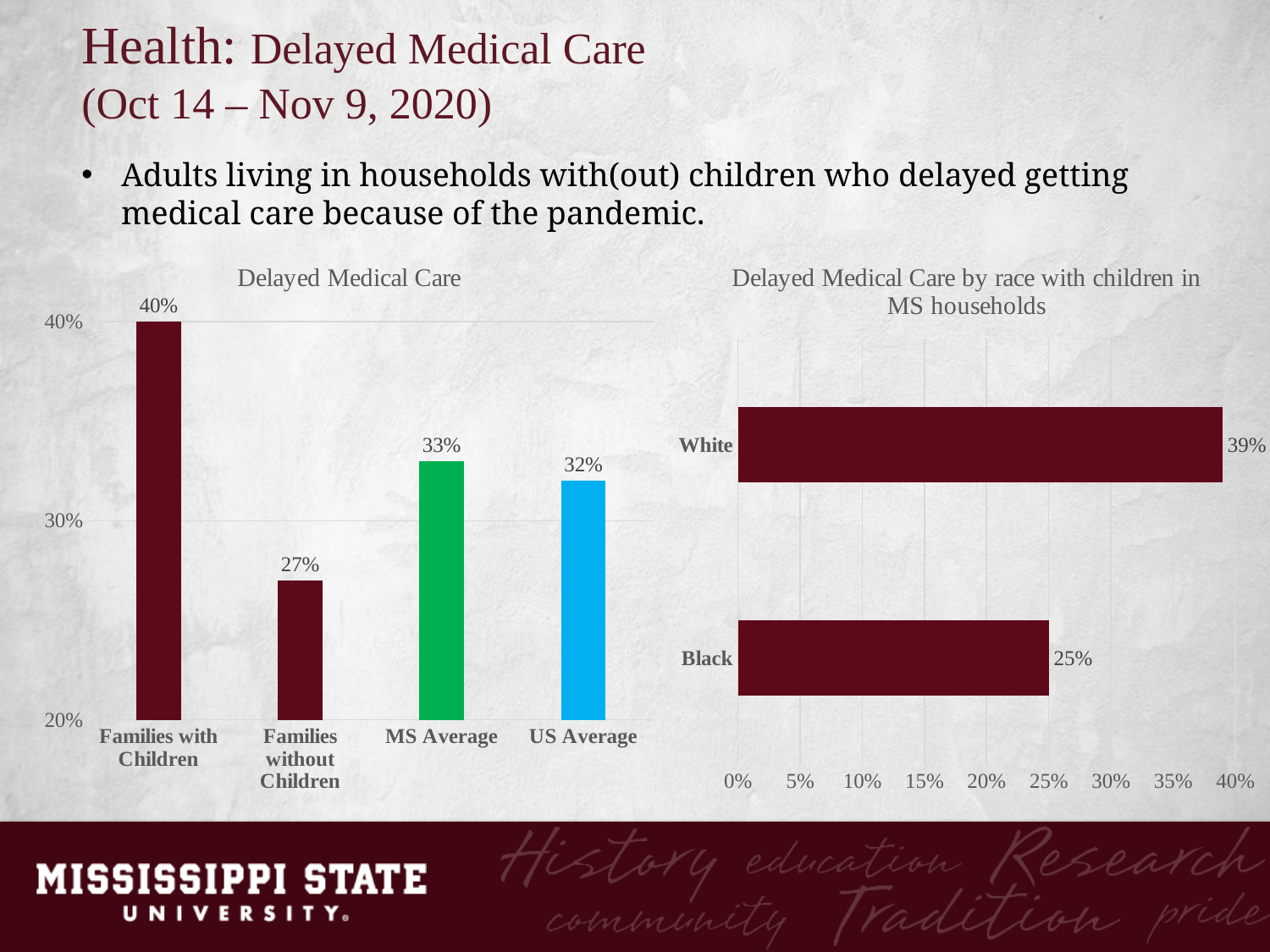
In the 'Delayed Medical Care' chart, what colour is the MS Average bar? Green In the 'Delayed Medical Care by race with children in MS households' chart, what is the value for White? 39% In the 'Delayed Medical Care' chart, what is the value for Families with Children? 40% In the 'Delayed Medical Care' chart, what is the value for MS Average? 33% In the 'Delayed Medical Care by race with children in MS households' chart, what is the difference between White and Black? 14% What kind of chart is the 'Delayed Medical Care by race with children in MS households' chart? Bar chart In the 'Delayed Medical Care' chart, what is the value for Families without Children? 27% In the 'Delayed Medical Care' chart, which category has the lowest value? Families without Children In the 'Delayed Medical Care by race with children in MS households' chart, what is the value for Black? 25% In the 'Delayed Medical Care' chart, which is larger, MS Average or US Average? MS Average In the 'Delayed Medical Care' chart, how many categories are shown? 4 In the 'Delayed Medical Care' chart, what is the difference between Families with Children and Families without Children? 13%